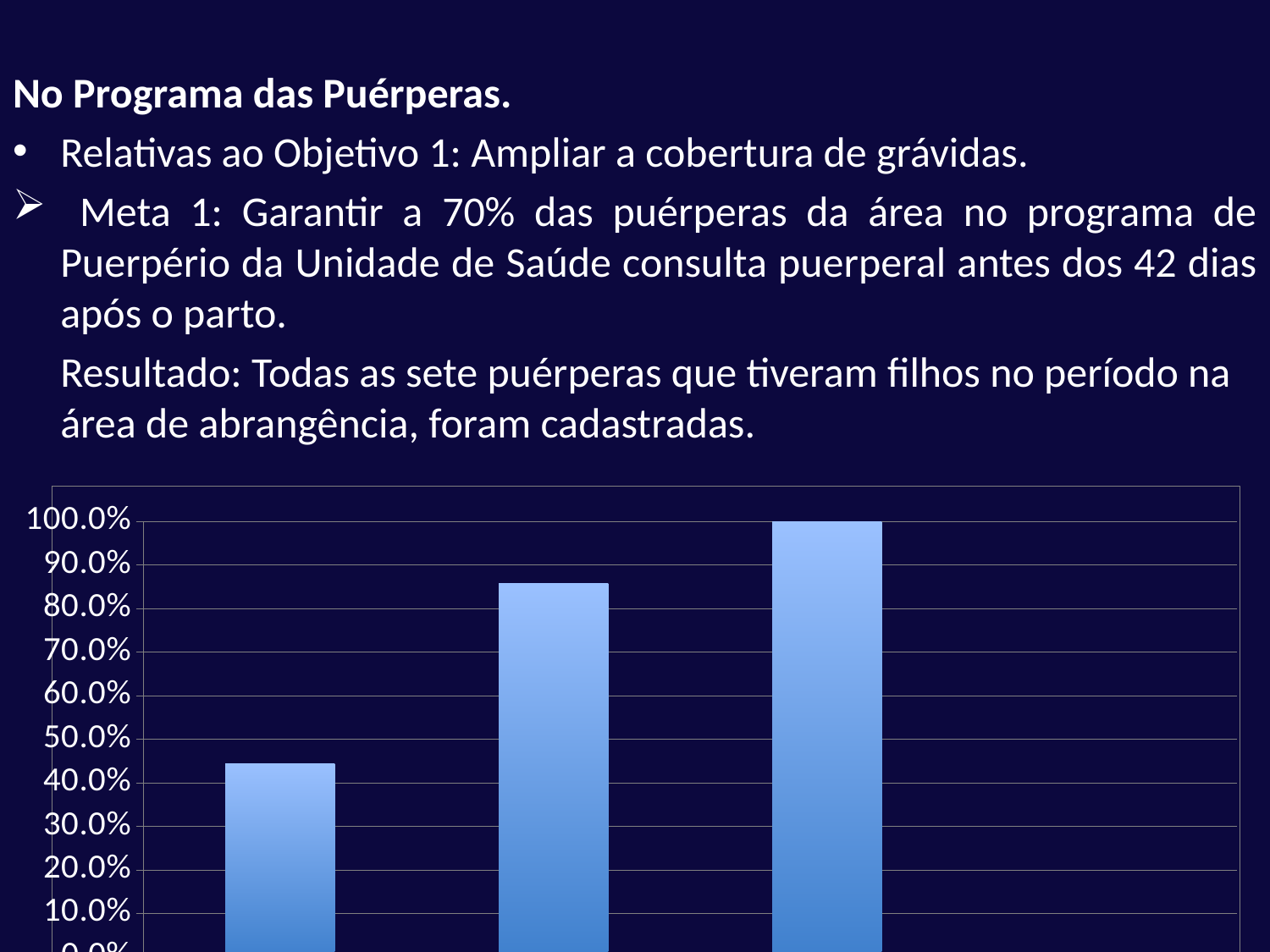
What is the highest value shown on the y axis of the chart? 100.0% Is the value of the first (leftmost) bar greater or less than 50.0%? less Is the value of the first (leftmost) bar greater or less than 40.0%? greater Which bar is the tallest in the chart: the first, second or third from the left? third Is the value of the second (middle) bar greater or less than 80.0%? greater What kind of chart is shown on the slide? bar chart Do the bar values rise or fall from left to right across the chart? rise What value does the third (rightmost) bar reach on the y axis? 100.0% How many bars are plotted in the chart? 3 Which bar is the shortest in the chart: the first, second or third from the left? first Which is larger, the first bar or the second bar? the second bar